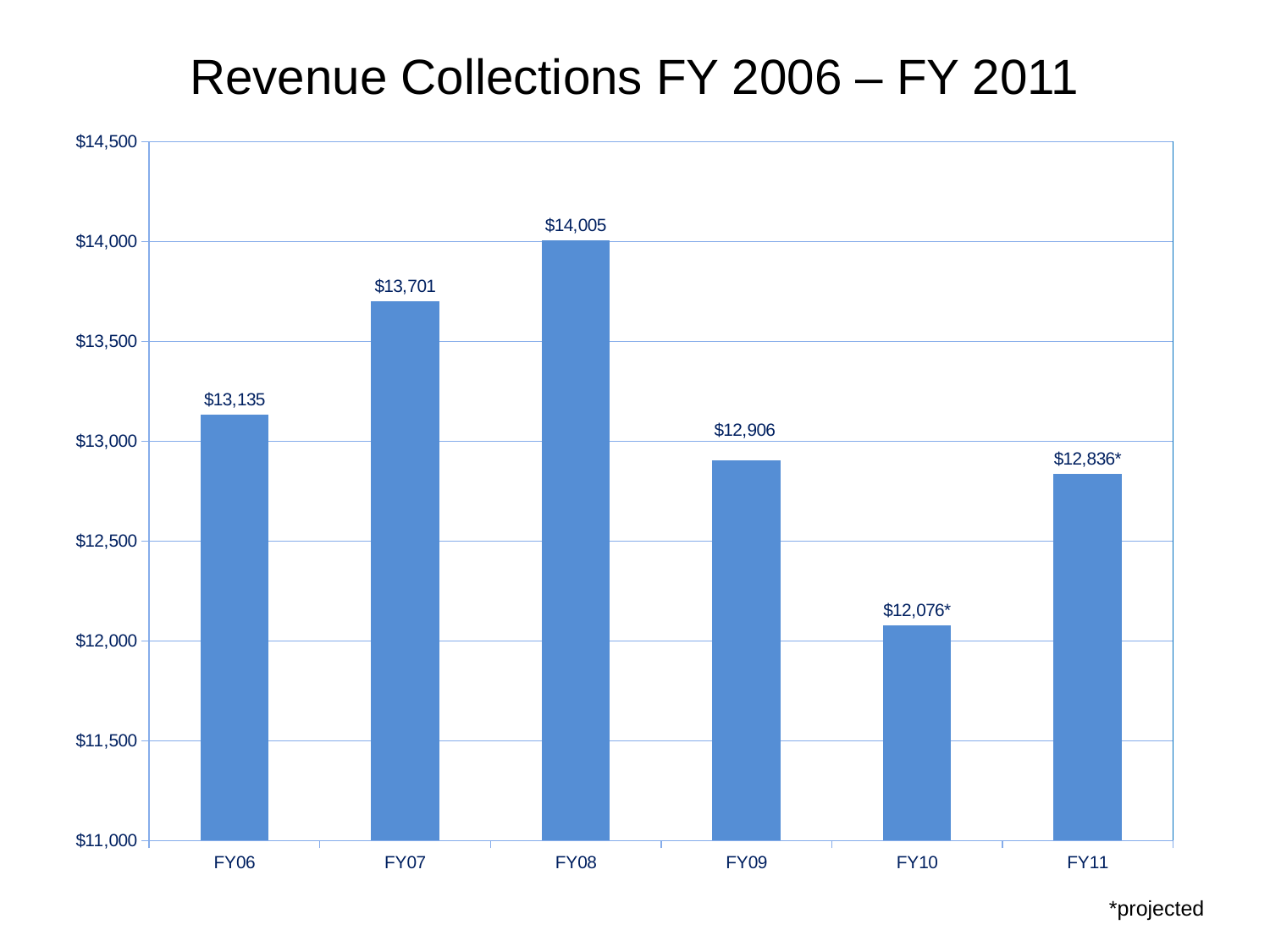
What is the difference between the FY08 and FY07 revenue collections? $304 Which is larger, the revenue collections for FY09 or FY11? FY09 Which fiscal year has the highest revenue collections? FY08 How many fiscal years are shown on the chart? 6 What is the revenue collection value for FY08? $14,005 What is the revenue collection value for FY06? $13,135 What does the asterisk on the FY10 and FY11 labels indicate? projected Do the revenue collections rise or fall from FY08 to FY10? fall What is the projected revenue collection value for FY10? $12,076 Is the value for FY07 greater or less than $13,500? greater Which fiscal year has the lowest revenue collections? FY10 What kind of chart is shown on the slide? bar chart